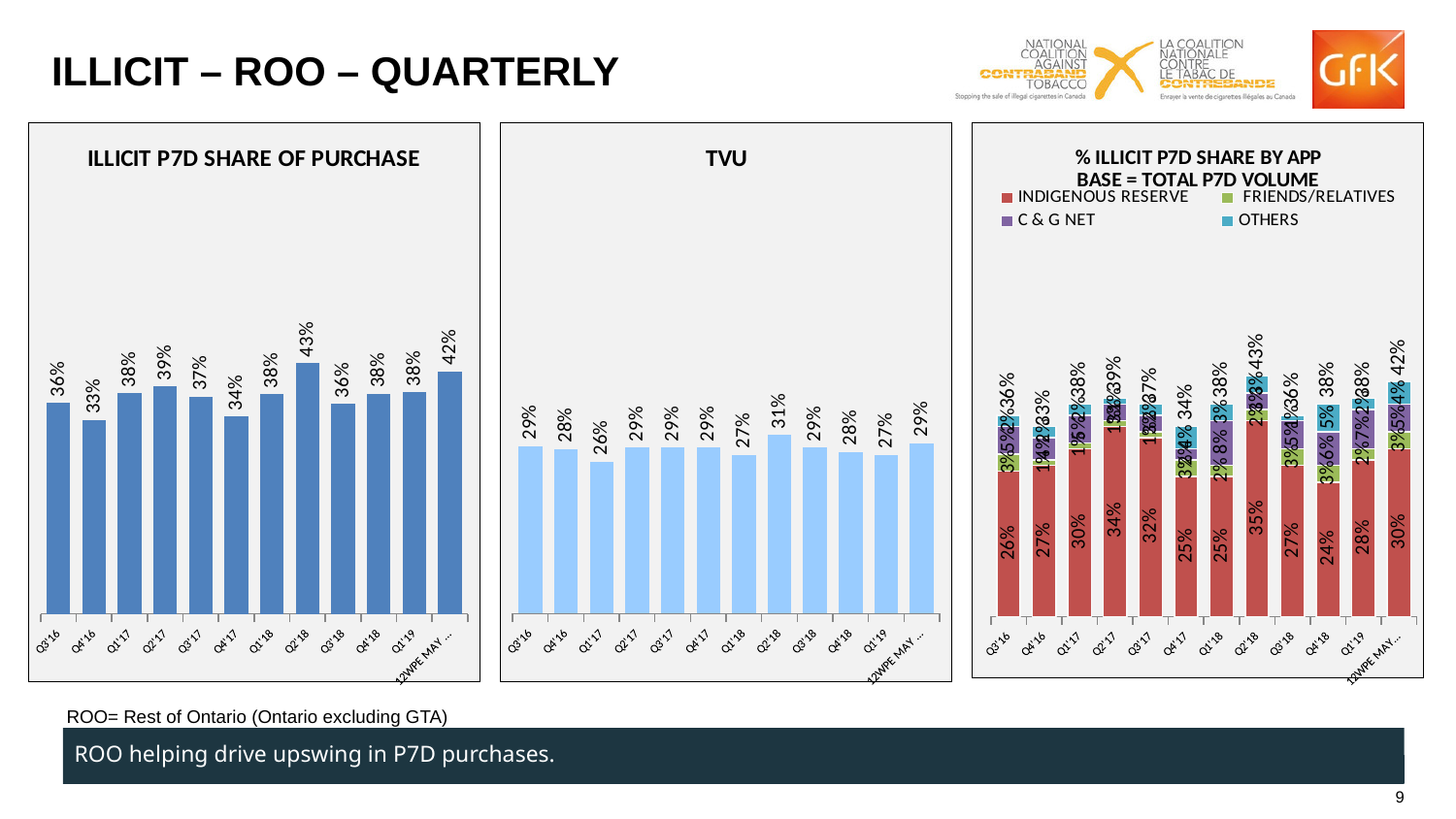
In the TVU chart, what is the value for Q1'18? 27% In the TVU chart, which quarter has the lowest value? Q1'17 In the ILLICIT P7D SHARE OF PURCHASE chart, which quarter has the lowest value? Q4'16 What kind of chart is the % ILLICIT P7D SHARE BY APP chart? Stacked bar chart In the TVU chart, which quarter has the highest value? Q2'18 In the ILLICIT P7D SHARE OF PURCHASE chart, what is the value for Q2'18? 43% In the ILLICIT P7D SHARE OF PURCHASE chart, which quarter has the highest value? Q2'18 In the ILLICIT P7D SHARE OF PURCHASE chart, what is the difference between the Q2'18 value and the Q4'16 value? 10 percentage points In the ILLICIT P7D SHARE OF PURCHASE chart, which is larger, the value for Q2'17 or the value for Q4'17? Q2'17 In the % ILLICIT P7D SHARE BY APP chart, what is the Indigenous Reserve value for Q2'18? 35% How many series does the legend of the % ILLICIT P7D SHARE BY APP chart list? 4 How many bars are plotted in the TVU chart? 12